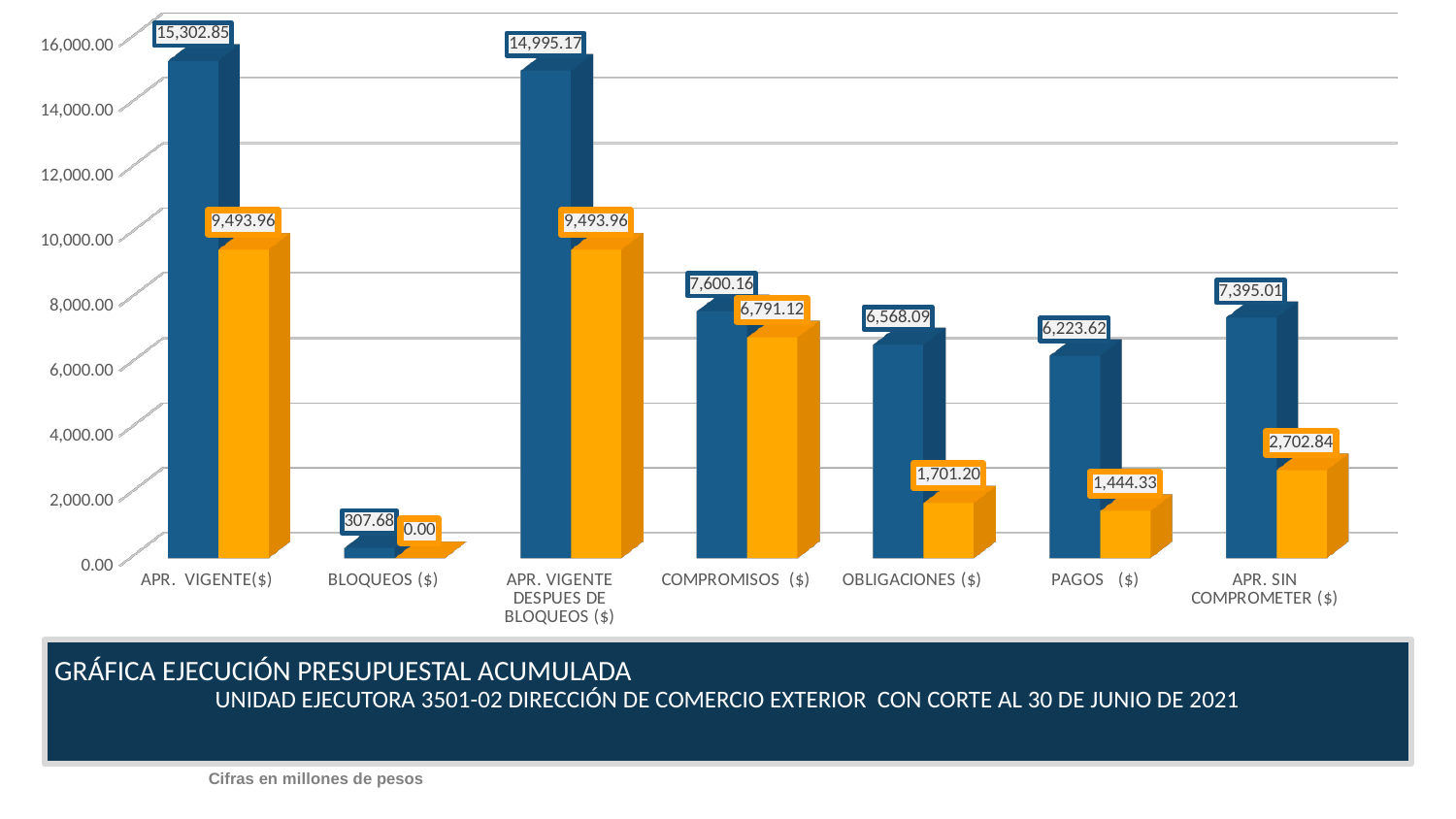
What is the value of the orange bar for BLOQUEOS ($)? 0.00 What is the value of the blue bar for PAGOS ($)? 6,223.62 How many categories are shown on the x axis? 7 What is the value of the orange bar for COMPROMISOS ($)? 6,791.12 Which category has the highest blue bar? APR. VIGENTE($) Is the blue bar for COMPROMISOS ($) greater or less than 8,000.00? less Which is larger: the orange bar for APR. SIN COMPROMETER ($) or the orange bar for PAGOS ($)? APR. SIN COMPROMETER ($) What kind of chart is shown on the slide? bar chart Which category has the lowest orange bar? BLOQUEOS ($) What is the value of the blue bar for APR. VIGENTE($)? 15,302.85 What is the difference between the blue and orange bars for OBLIGACIONES ($)? 4,866.89 What unit are the figures in, according to the note below the chart? millones de pesos